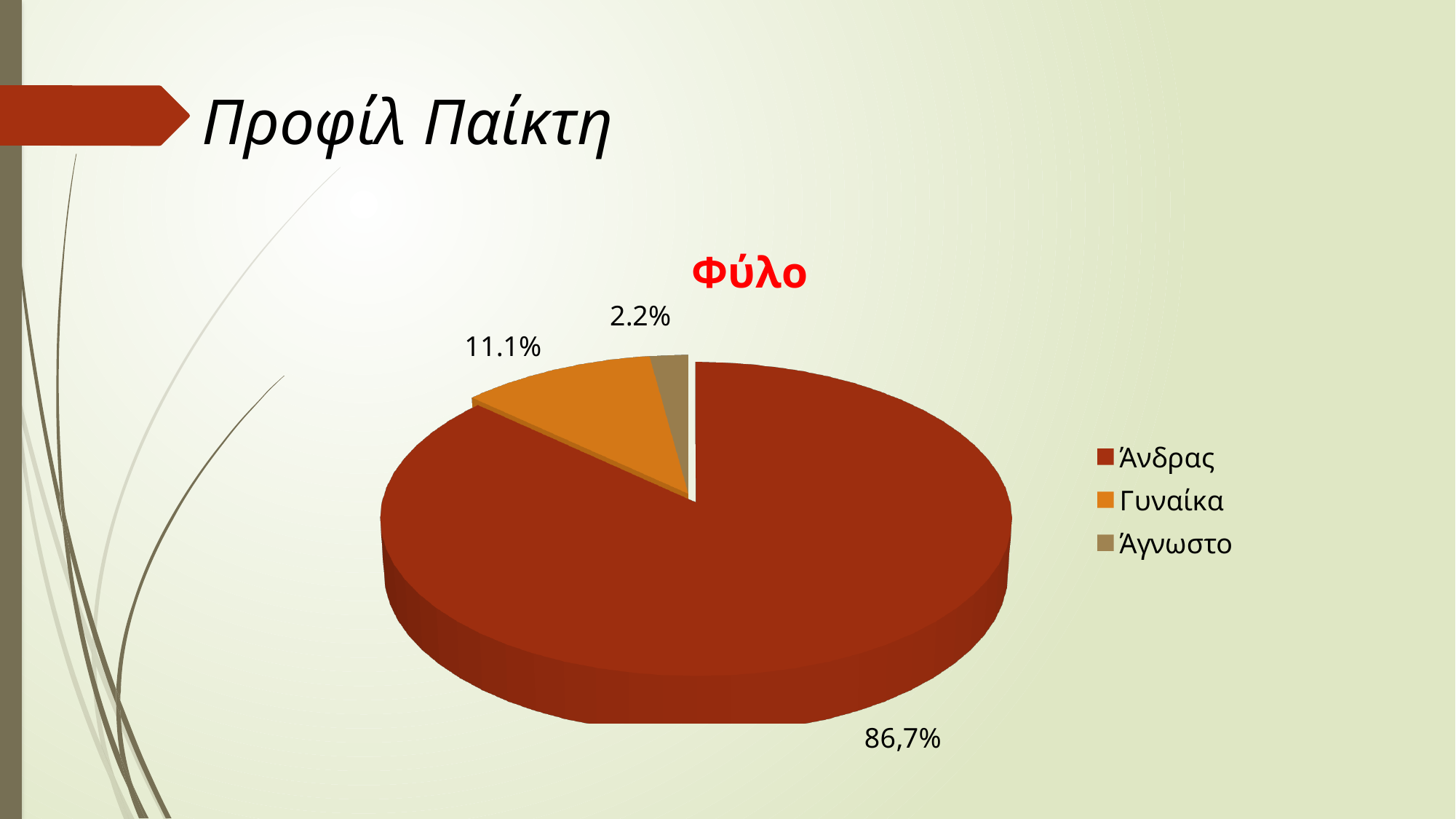
What is the title of the chart? Φύλο Which category has the largest slice of the pie? Άνδρας What percentage of the pie is labelled for Άγνωστο? 2.2% What percentage of the pie is labelled for Άνδρας? 86,7% What colour is the Γυναίκα slice in the pie chart? orange What type of chart is shown on the slide? pie chart How many entries does the legend list? 3 Which slice is larger, Γυναίκα or Άγνωστο? Γυναίκα Which category has the smallest slice of the pie? Άγνωστο What percentage of the pie is labelled for Γυναίκα? 11.1% What is the difference in percentage points between the Γυναίκα slice and the Άγνωστο slice? 8.9 How many categories does the pie chart show? 3